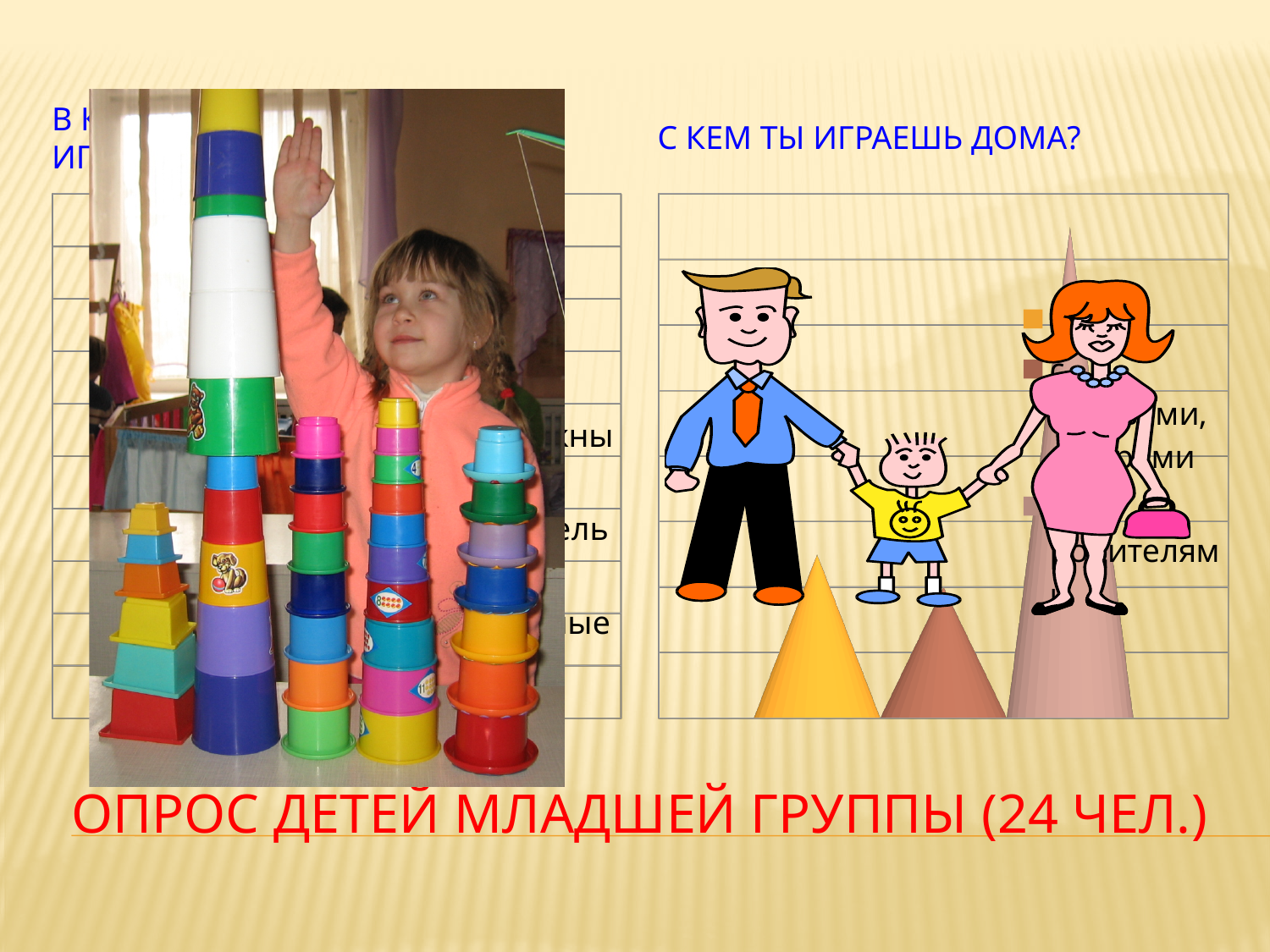
What is the title of the chart on the right side of the slide? С КЕМ ТЫ ИГРАЕШЬ ДОМА? In the chart titled 'С КЕМ ТЫ ИГРАЕШЬ ДОМА?', which bar is the tallest? the rightmost (pinkish-tan) bar In the chart titled 'С КЕМ ТЫ ИГРАЕШЬ ДОМА?', which bar is the shortest? the middle (brown) bar In the chart titled 'С КЕМ ТЫ ИГРАЕШЬ ДОМА?', what shape are the bars drawn as? cones In the chart titled 'С КЕМ ТЫ ИГРАЕШЬ ДОМА?', how many bars are plotted? 3 What kind of chart is the chart titled 'С КЕМ ТЫ ИГРАЕШЬ ДОМА?'? bar chart In the chart titled 'С КЕМ ТЫ ИГРАЕШЬ ДОМА?', which is taller: the yellow bar on the left or the brown bar in the middle? the yellow bar on the left